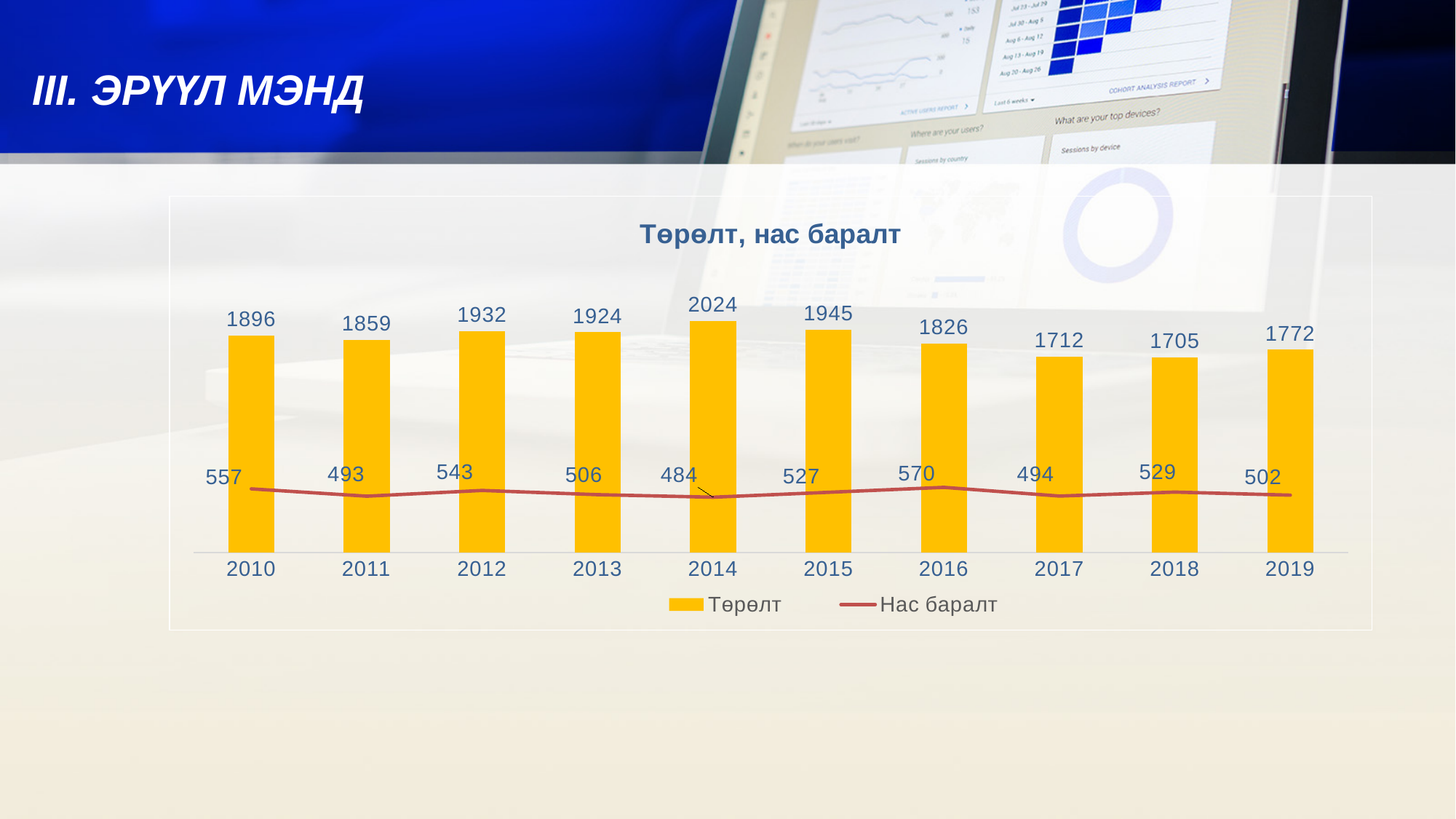
What is the Нас баралт value for 2016? 570 What colour are the Төрөлт bars? Yellow Which is larger, the Нас баралт value for 2010 or for 2011? 2010 Which year has the highest Төрөлт value? 2014 What is the difference between the Төрөлт values for 2014 and 2019? 252 How many years are shown on the x axis? 10 What is the Төрөлт value for 2018? 1705 What is the title of the chart? Төрөлт, нас баралт Which year has the lowest Төрөлт value? 2018 How many series does the legend list? 2 What is the Төрөлт value for 2014? 2024 Which year has the lowest Нас баралт value? 2014